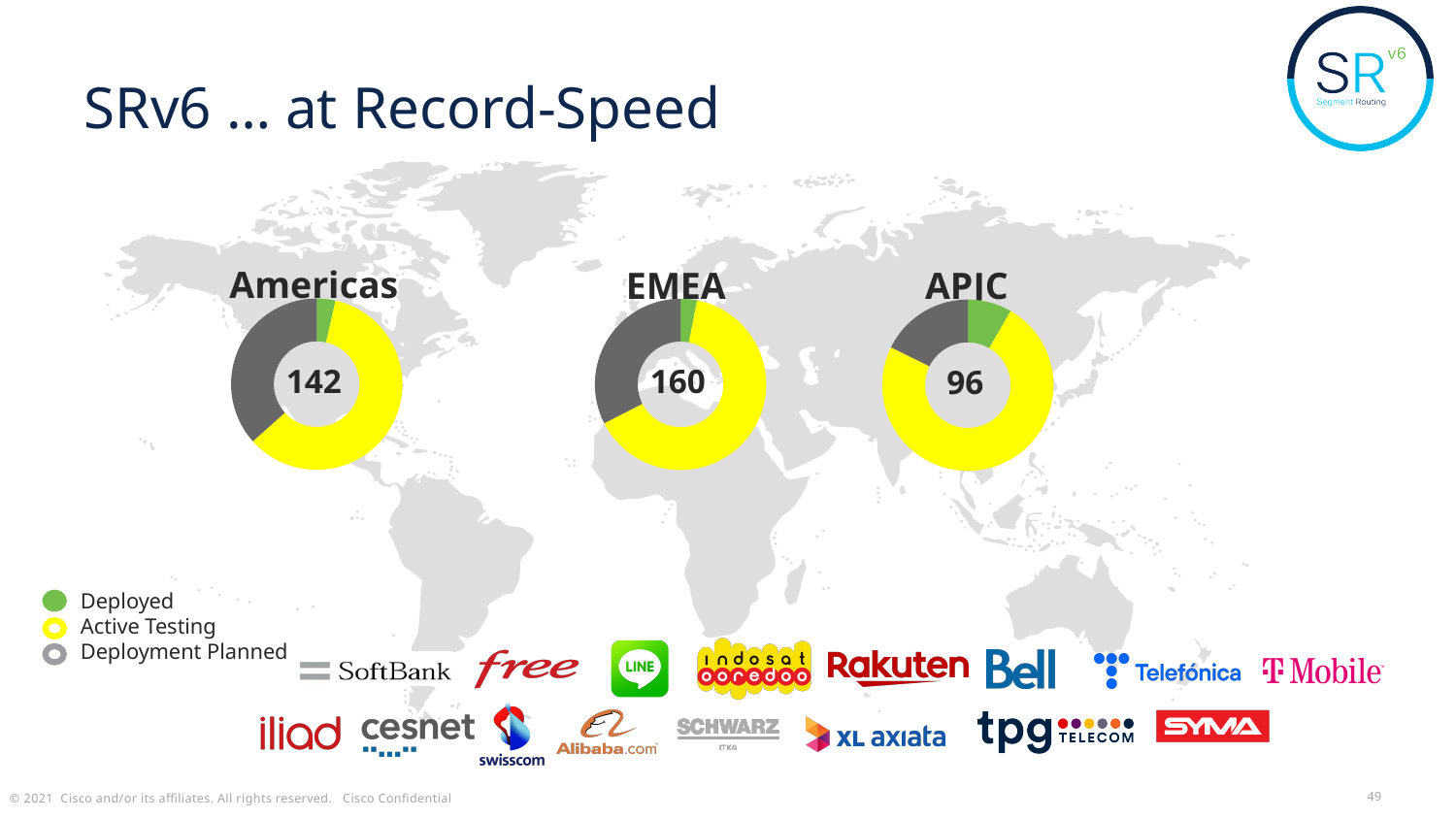
How many categories does the legend list for the donut charts? 3 What kind of chart is used to show the Americas, EMEA and APIC data? Donut (pie) chart Which has a larger center number, the Americas chart or the APIC chart? Americas What number is shown in the center of the Americas donut chart? 142 What is the difference between the center numbers of the Americas and APIC donut charts? 46 What number is shown in the center of the EMEA donut chart? 160 Which region's donut chart shows the lowest center number? APIC What is the difference between the center numbers of the EMEA and Americas donut charts? 18 In the EMEA donut chart, which category takes up the largest share of the ring? Active Testing How many donut charts are shown on the slide? 3 What number is shown in the center of the APIC donut chart? 96 Which region's donut chart shows the highest center number? EMEA